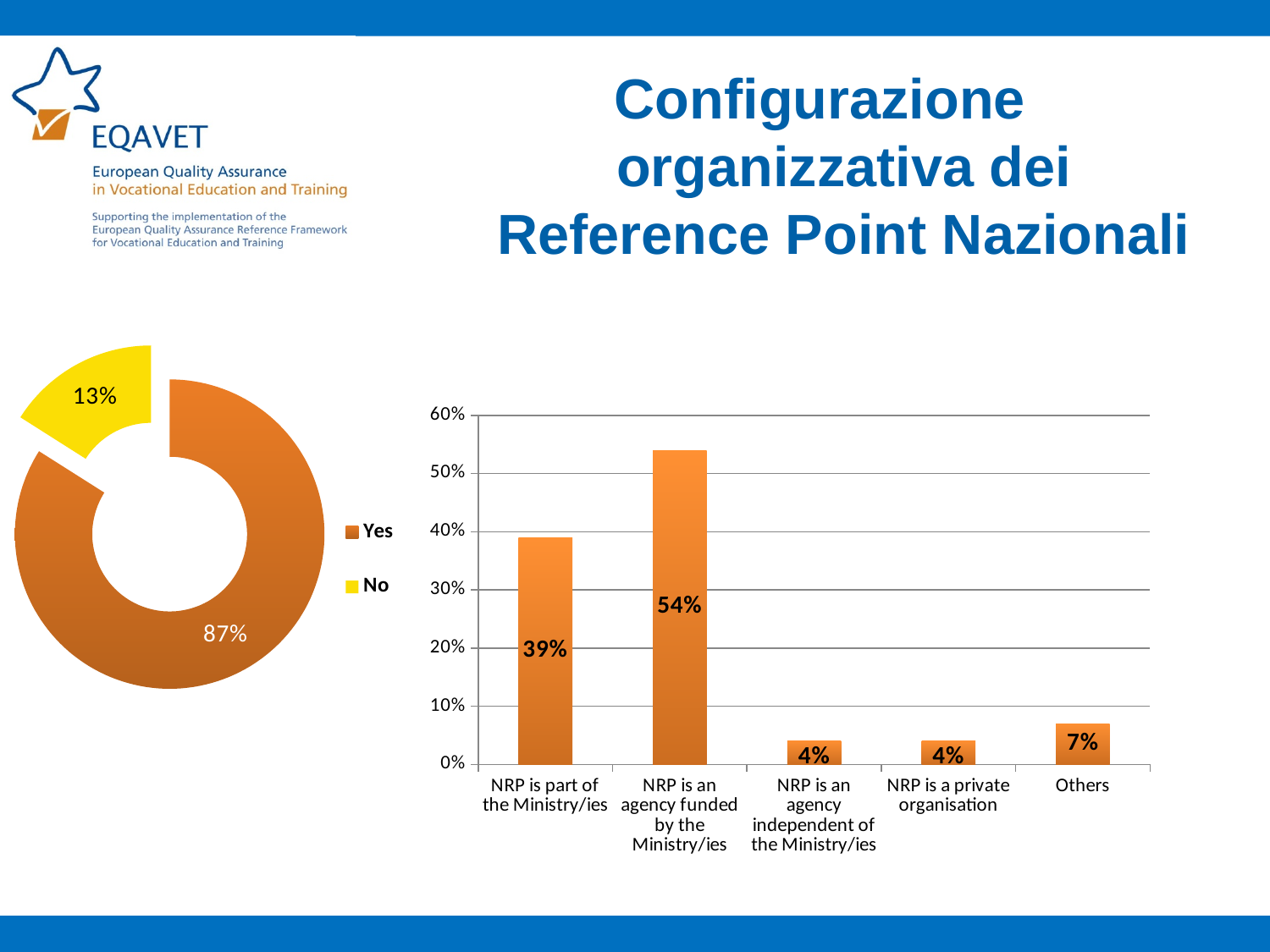
In the bar chart on the right, which category has the highest value? NRP is an agency funded by the Ministry/ies In the bar chart on the right, what is the value for 'NRP is an agency funded by the Ministry/ies'? 54% In the doughnut chart on the left, how many entries does the legend list? 2 What kind of chart is shown on the right of the slide? Bar chart In the doughnut chart on the left, what percentage is shown for Yes? 87% In the bar chart on the right, what is the difference between 'NRP is an agency funded by the Ministry/ies' and 'NRP is part of the Ministry/ies'? 15% In the bar chart on the right, how many categories are shown on the x axis? 5 In the bar chart on the right, which is larger: 'NRP is part of the Ministry/ies' or Others? NRP is part of the Ministry/ies In the bar chart on the right, what is the value for 'NRP is part of the Ministry/ies'? 39% In the doughnut chart on the left, which colour represents No? Yellow In the bar chart on the right, what is the value for Others? 7% In the doughnut chart on the left, what percentage is shown for No? 13%